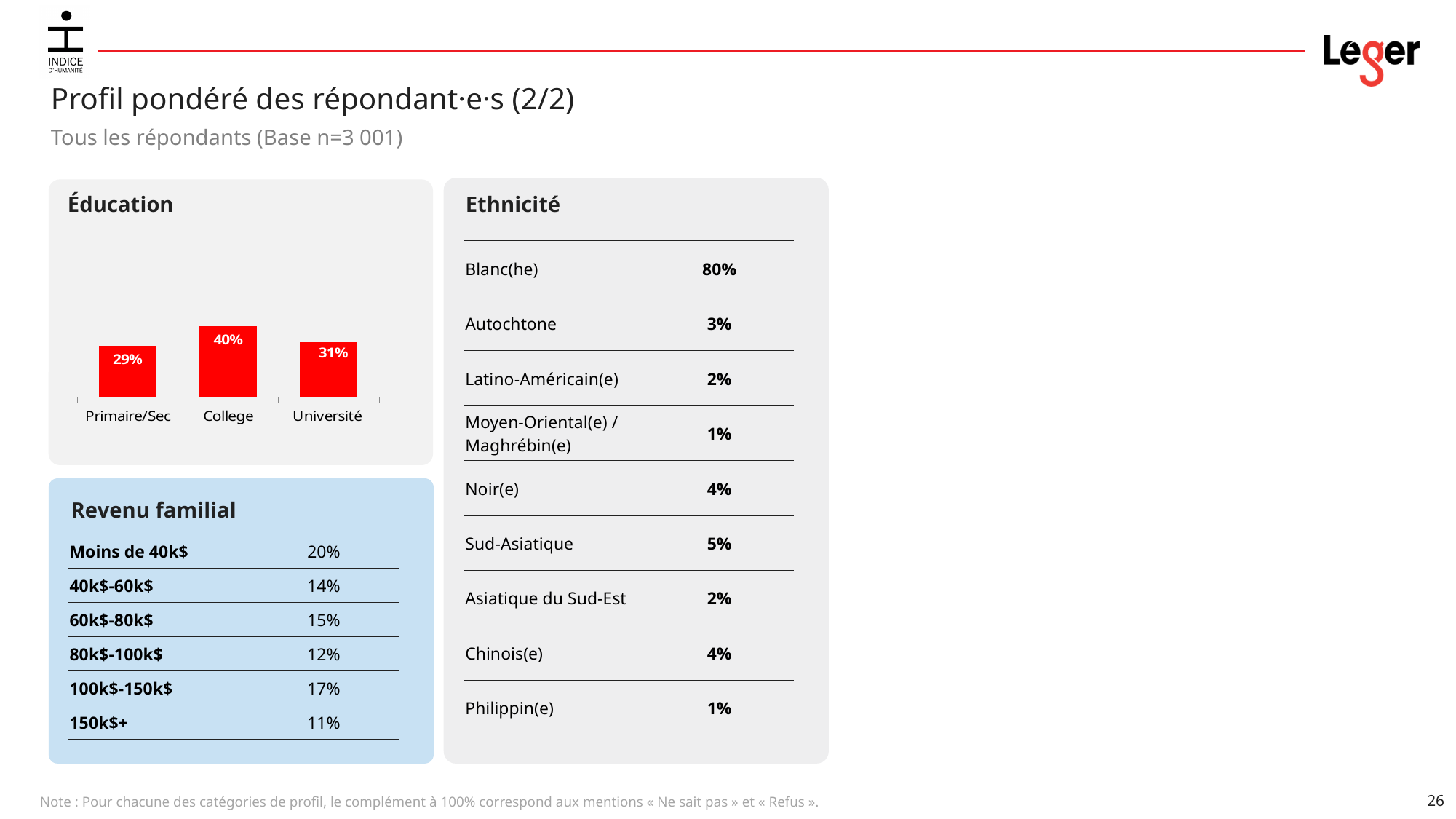
In the Éducation chart, what is the difference between the values for Université and Primaire/Sec? 2% In the Éducation chart, which category has the lowest value? Primaire/Sec In the Éducation chart, what is the value for Université? 31% What is the title of the chart on the slide? Éducation In the Éducation chart, what is the value for Primaire/Sec? 29% What kind of chart is the Éducation chart? Bar chart How many categories are shown in the Éducation chart? 3 In the Éducation chart, which category has the highest value? College In the Éducation chart, which is larger, the value for College or the value for Primaire/Sec? College In the Éducation chart, what is the difference between the values for College and Université? 9% What colour are the bars in the Éducation chart? Red In the Éducation chart, what is the value for College? 40%